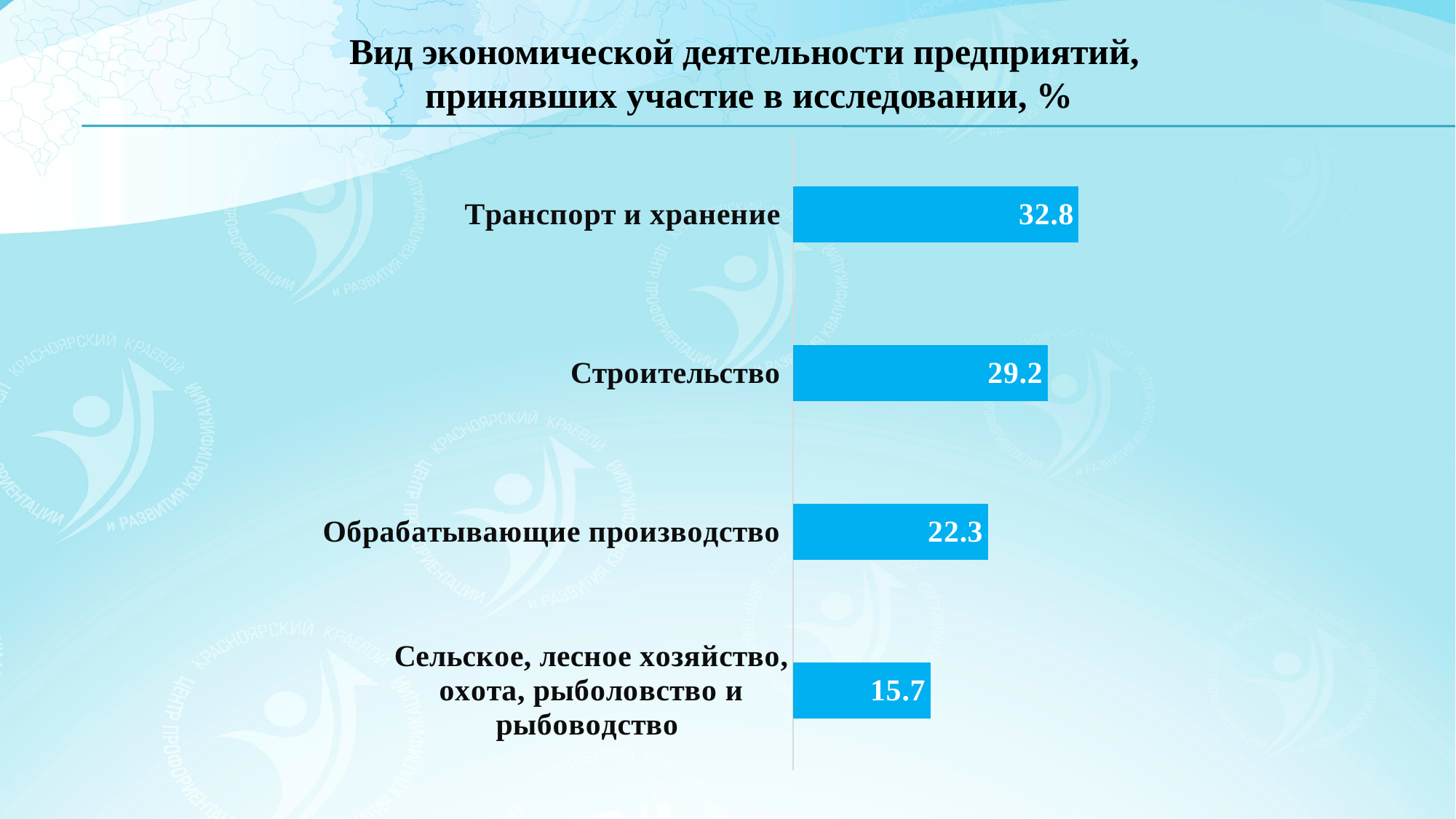
Which category has the highest value? Транспорт и хранение What is the value for Транспорт и хранение? 32.8 What is the value for Строительство? 29.2 Which category has the lowest value? Сельское, лесное хозяйство, охота, рыболовство и рыбоводство What is the value for Обрабатывающие производство? 22.3 What kind of chart is shown on the slide? bar chart What is the difference between the values for Транспорт и хранение and Строительство? 3.6 What is the difference between the values for Обрабатывающие производство and Сельское, лесное хозяйство, охота, рыболовство и рыбоводство? 6.6 What is the title of the chart? Вид экономической деятельности предприятий, принявших участие в исследовании, % How many categories are shown in the chart? 4 Which is larger: the value for Строительство or the value for Обрабатывающие производство? Строительство What is the value for Сельское, лесное хозяйство, охота, рыболовство и рыбоводство? 15.7